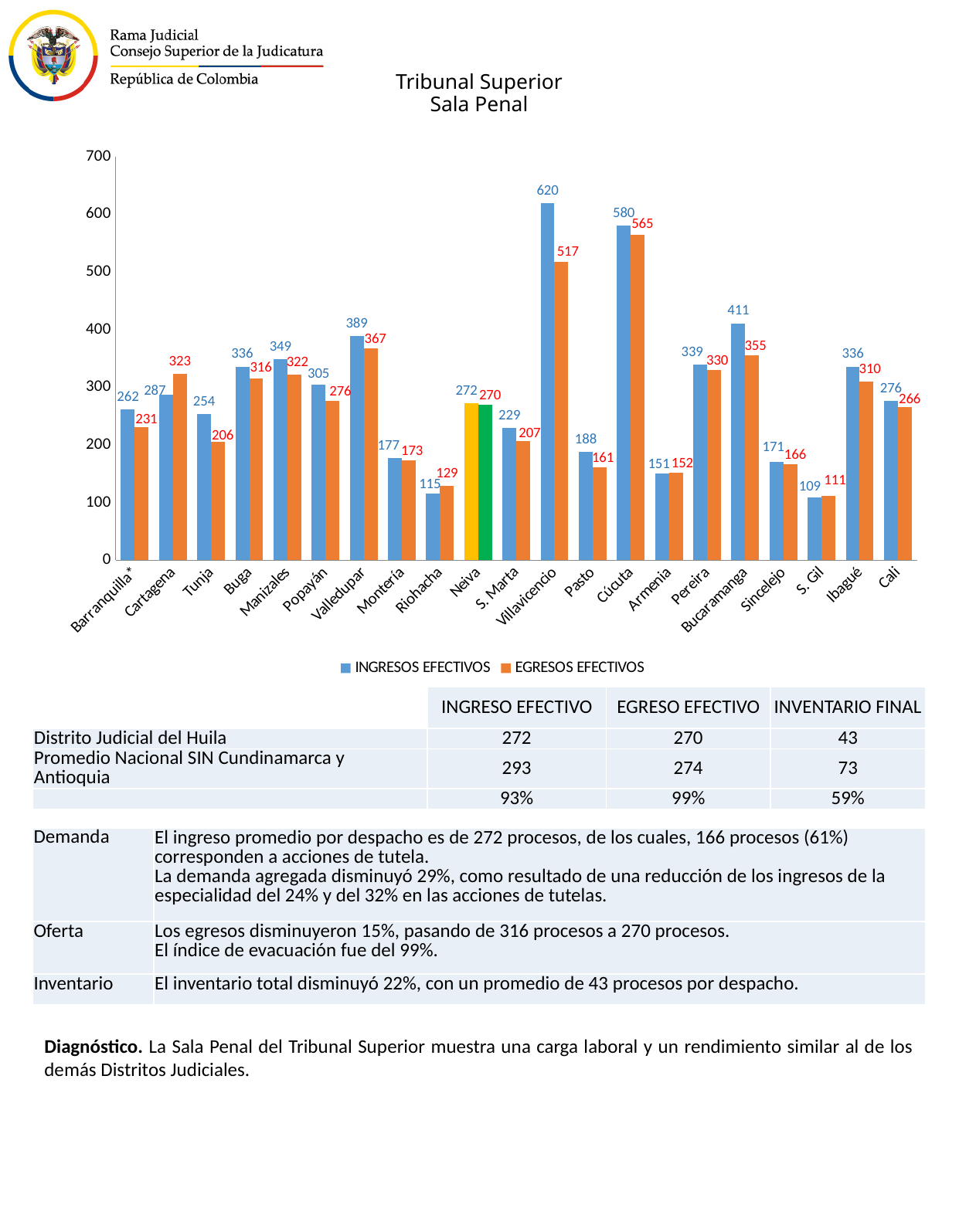
How many series does the chart legend list? 2 What is the EGRESOS EFECTIVOS value for Neiva? 270 Is the INGRESOS EFECTIVOS value for Cúcuta greater or less than 500? greater What is the title of the chart? Tribunal Superior Sala Penal What type of chart is shown on the slide? bar chart Which city has the lowest EGRESOS EFECTIVOS value? S. Gil What is the difference between INGRESOS EFECTIVOS and EGRESOS EFECTIVOS for Villavicencio? 103 How many cities are shown on the x axis of the chart? 21 What is the INGRESOS EFECTIVOS value for Villavicencio? 620 Which city has the highest INGRESOS EFECTIVOS value? Villavicencio Which is larger for Cartagena: INGRESOS EFECTIVOS or EGRESOS EFECTIVOS? EGRESOS EFECTIVOS What is the EGRESOS EFECTIVOS value for Bucaramanga? 355